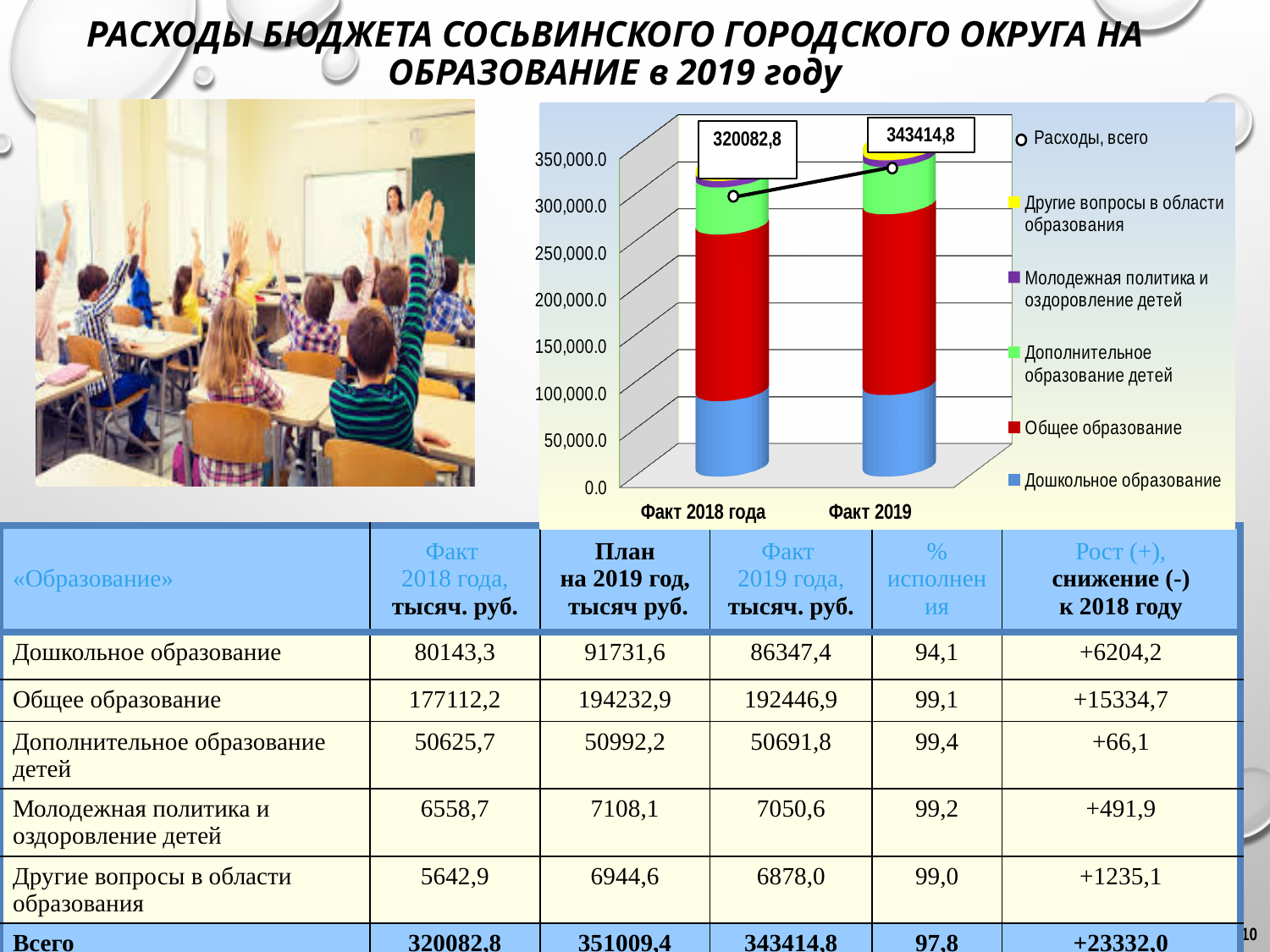
How many series does the chart legend list? 6 Is the 'Дошкольное образование' segment for 'Факт 2018 года' greater or less than 100,000.0? less Which colour represents 'Общее образование' in the chart? red Which legend entry is shown in yellow? Другие вопросы в области образования By how much does the 'Расходы, всего' value for 'Факт 2019' exceed the value for 'Факт 2018 года'? 23332,0 Does the 'Расходы, всего' value rise or fall from 'Факт 2018 года' to 'Факт 2019'? rise What kind of chart is shown on the slide? stacked bar chart with a line Is the total height of the stacked bar for 'Факт 2019' greater or less than 300,000.0? greater Which category has the higher 'Расходы, всего' value, 'Факт 2018 года' or 'Факт 2019'? Факт 2019 How many categories are shown on the x axis of the chart? 2 What is the value of the 'Расходы, всего' series for 'Факт 2019'? 343414,8 What is the value of the 'Расходы, всего' series for 'Факт 2018 года'? 320082,8